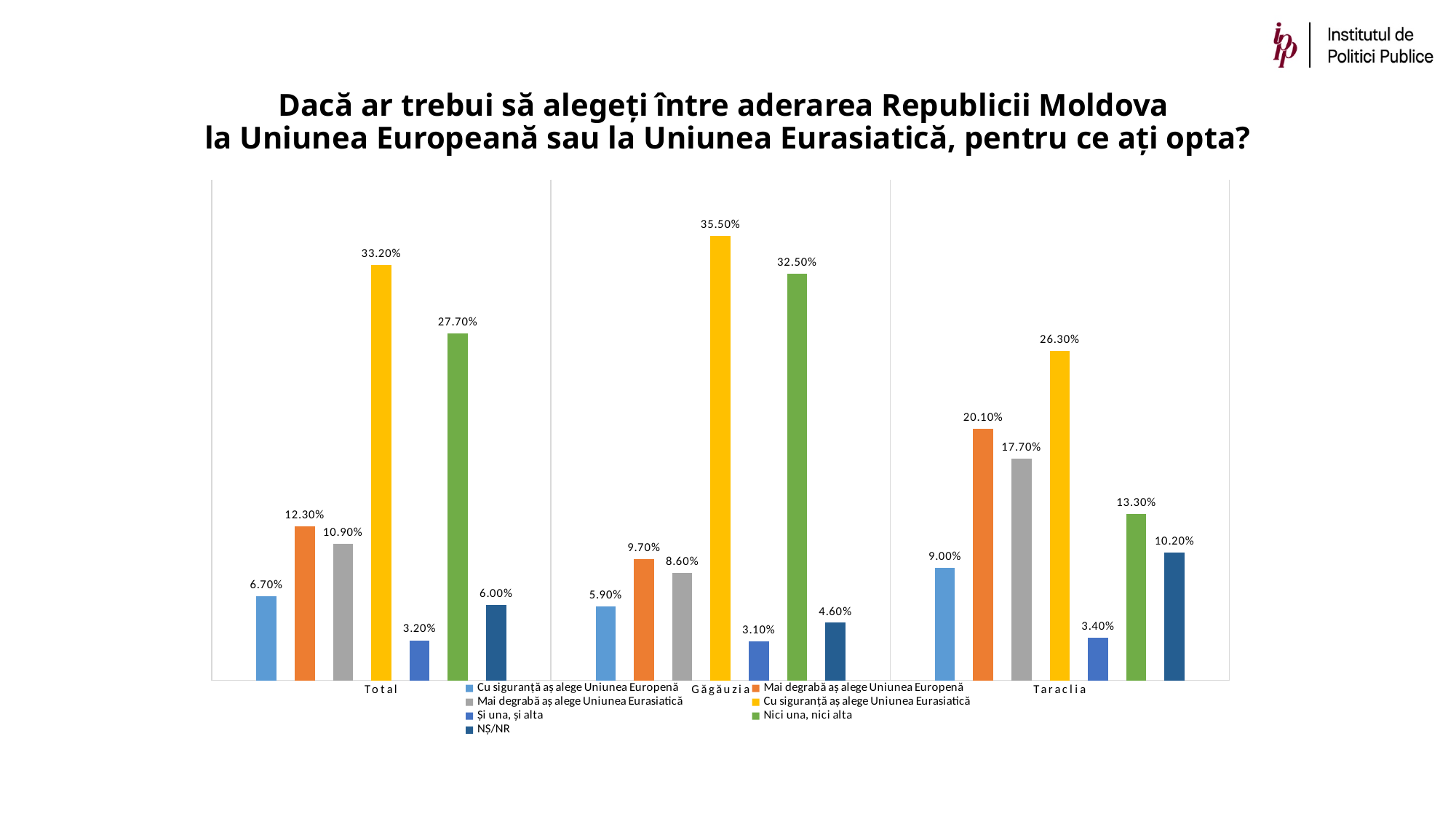
What is the difference between "Cu siguranță aș alege Uniunea Eurasiatică" and "Nici una, nici alta" in Găgăuzia? 3.00% What is the value for "Mai degrabă aș alege Uniunea Europeană" in Taraclia? 20.10% How many series does the legend list? 7 What is the value for "Nici una, nici alta" in Găgăuzia? 32.50% What is the value for "Cu siguranță aș alege Uniunea Eurasiatică" in the Total category? 33.20% How many categories are shown on the x axis? 3 Which is larger in Taraclia: "Mai degrabă aș alege Uniunea Europeană" or "Mai degrabă aș alege Uniunea Eurasiatică"? Mai degrabă aș alege Uniunea Europeană Which series has the lowest value in the Total category? Și una, și alta What colour are the bars for "Cu siguranță aș alege Uniunea Eurasiatică"? Yellow Which series has the highest value in Taraclia? Cu siguranță aș alege Uniunea Eurasiatică What is the value for "NȘ/NR" in Găgăuzia? 4.60% What kind of chart is shown on the slide? Bar chart